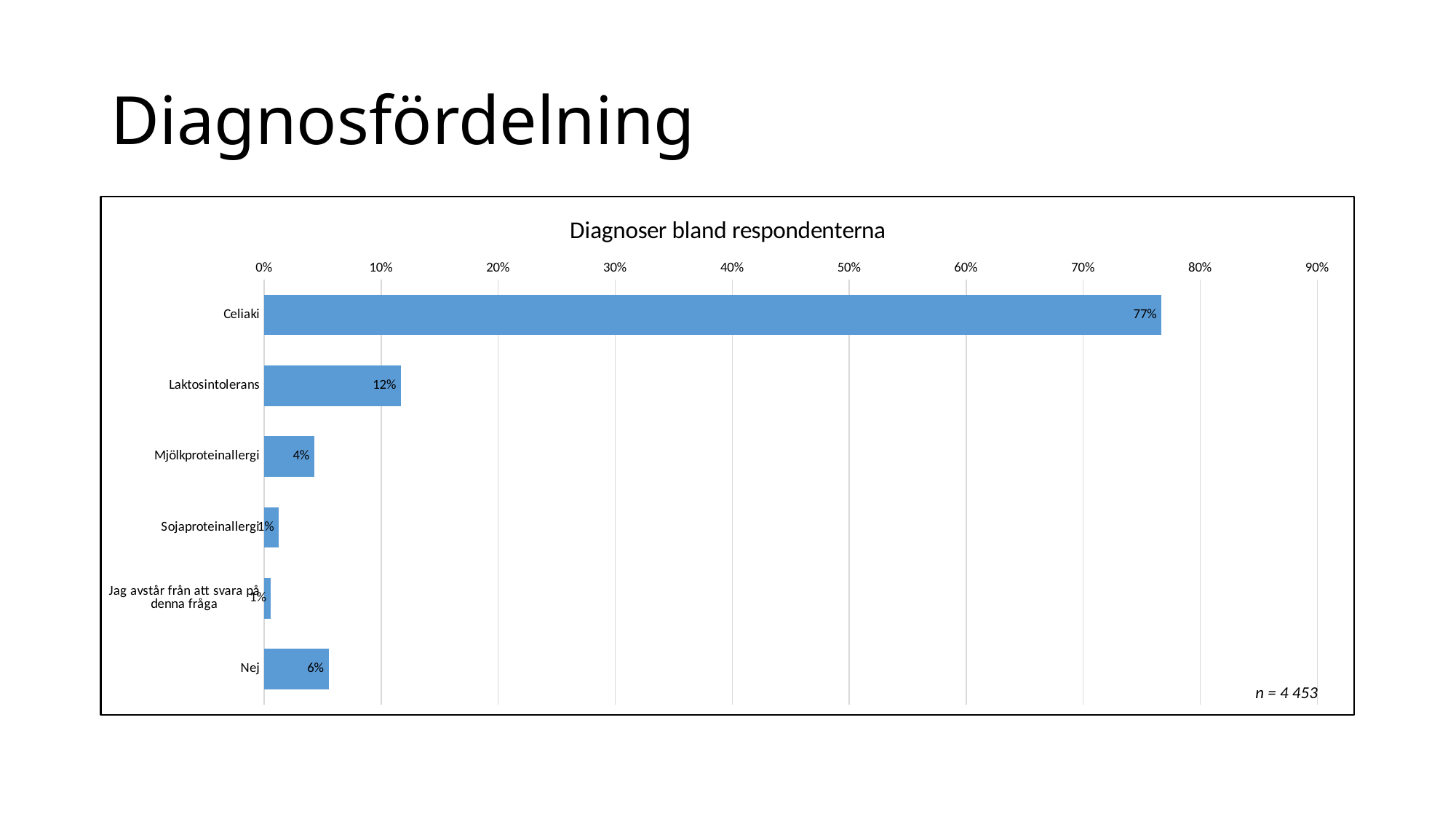
What is the value for Laktosintolerans? 12% What is the value for Celiaki? 77% What kind of chart is shown on the slide? bar chart What is the difference between the values for Celiaki and Laktosintolerans? 65% Which category has the highest value? Celiaki How many categories are shown in the chart? 6 What is the difference between the values for Nej and Mjölkproteinallergi? 2% Is the value for Celiaki greater or less than 70%? greater What is the value for Mjölkproteinallergi? 4% What is the value for Nej? 6% Which is larger, the value for Laktosintolerans or the value for Nej? Laktosintolerans What is the title of the chart? Diagnoser bland respondenterna